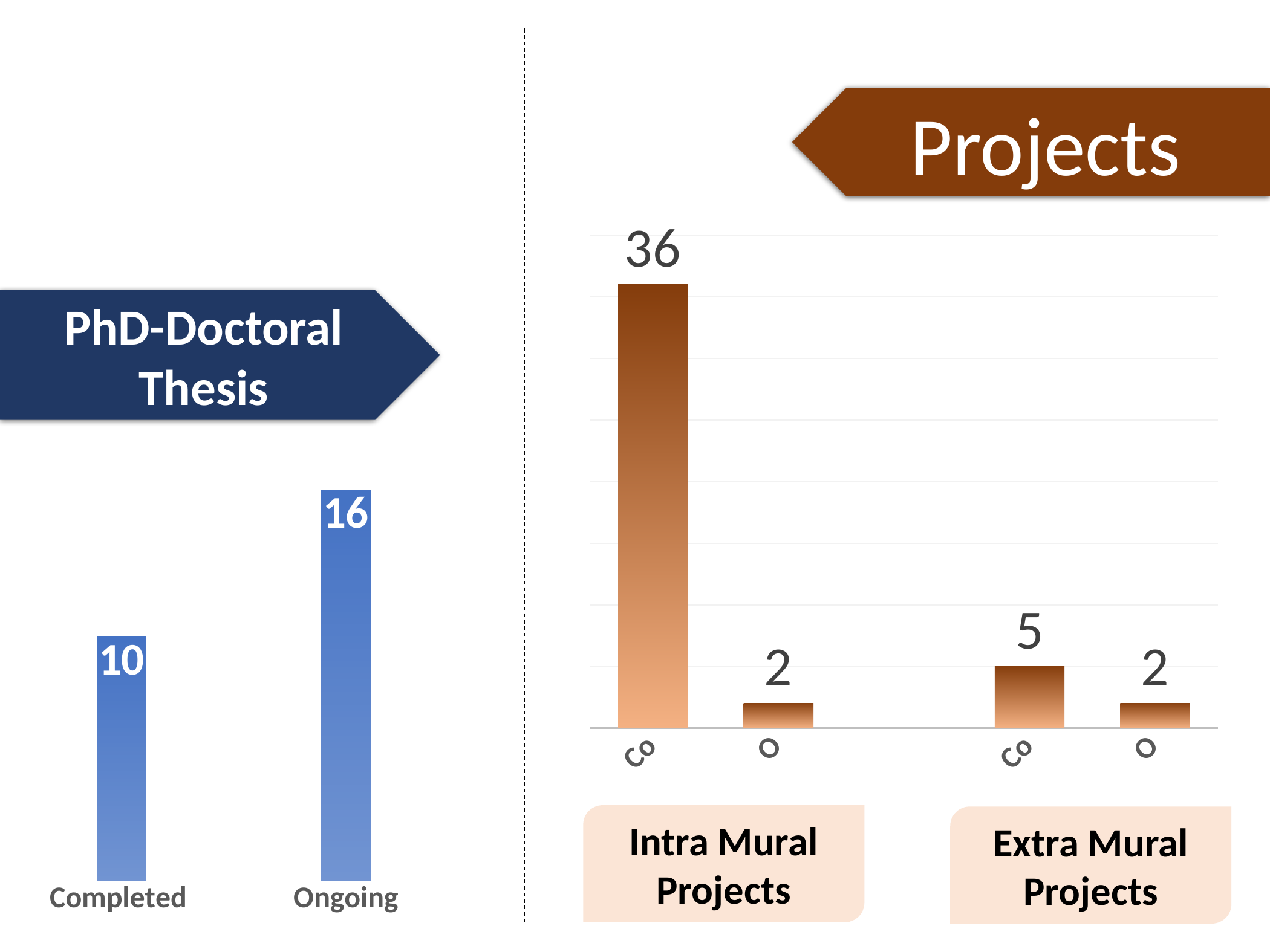
What kind of chart is the PhD-Doctoral Thesis chart? Bar chart In the Projects chart, which bar has the highest value? Co under Intra Mural Projects In the PhD-Doctoral Thesis chart, how many categories are shown? 2 In the Projects chart, how many bars are plotted in total? 4 In the Projects chart, what is the value of the Co bar under Intra Mural Projects? 36 In the Projects chart, what is the value of the Co bar under Extra Mural Projects? 5 In the PhD-Doctoral Thesis chart, what is the value for Ongoing? 16 In the PhD-Doctoral Thesis chart, which category has the higher value? Ongoing In the PhD-Doctoral Thesis chart, what is the value for Completed? 10 In the Projects chart, what is the difference between the Co bars for Intra Mural Projects and Extra Mural Projects? 31 In the PhD-Doctoral Thesis chart, what is the difference between Ongoing and Completed? 6 In the Projects chart, what is the value of the O bar under Intra Mural Projects? 2